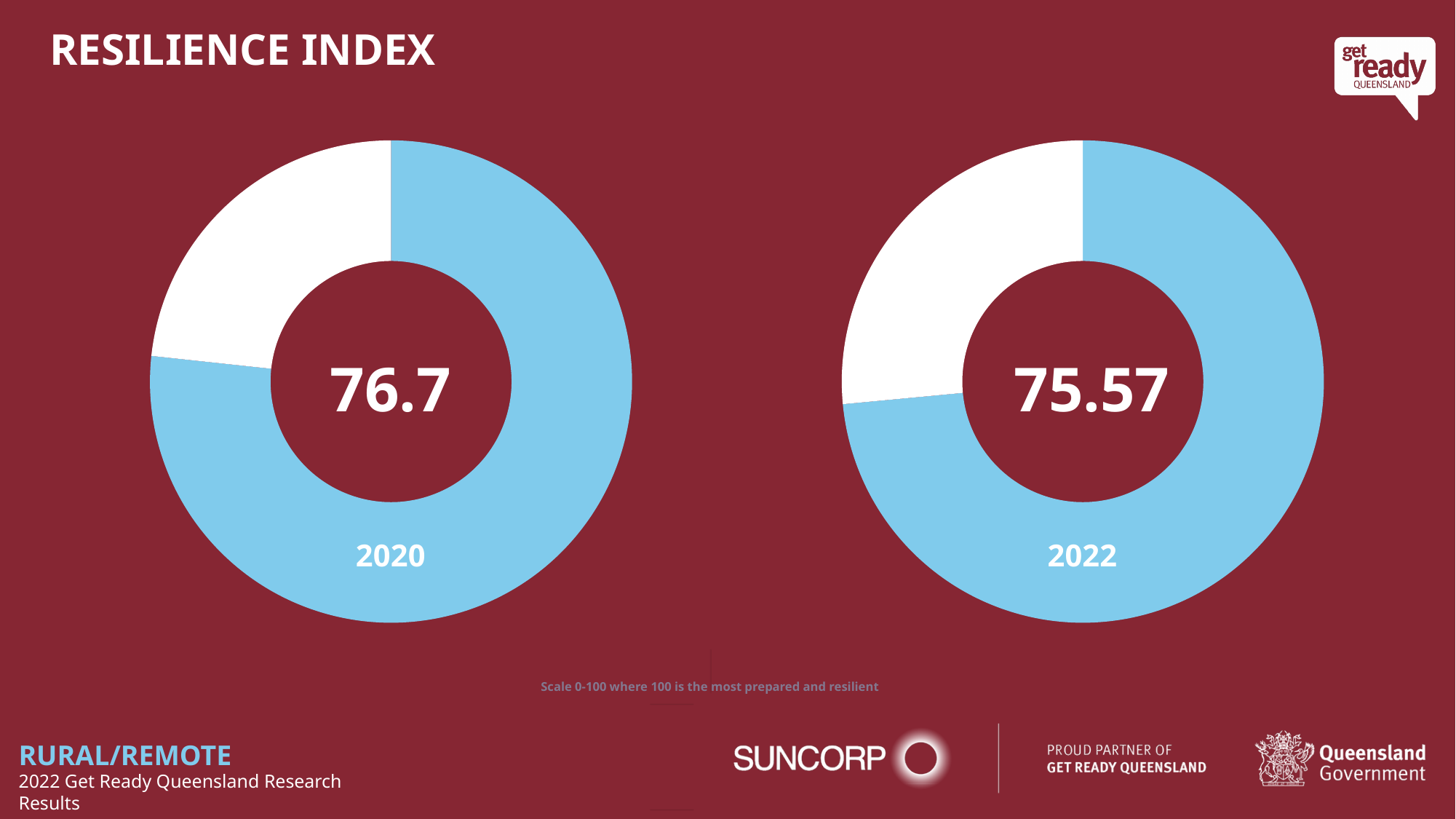
What is the resilience index value shown in the 2020 donut chart? 76.7 What kind of chart is used to display the resilience index for each year? donut (pie) chart According to the note below the charts, what scale is the resilience index measured on? 0-100 where 100 is the most prepared and resilient What is the resilience index value shown in the 2022 donut chart? 75.57 Which year shows the lowest resilience index on the slide? 2022 Did the resilience index rise or fall from 2020 to 2022? fall How many donut charts are shown on the slide? 2 Which years are labelled on the two donut charts? 2020 and 2022 Which year has the higher resilience index, 2020 or 2022? 2020 What is the title of the slide containing the donut charts? RESILIENCE INDEX By how much did the resilience index change from 2020 to 2022? 1.13